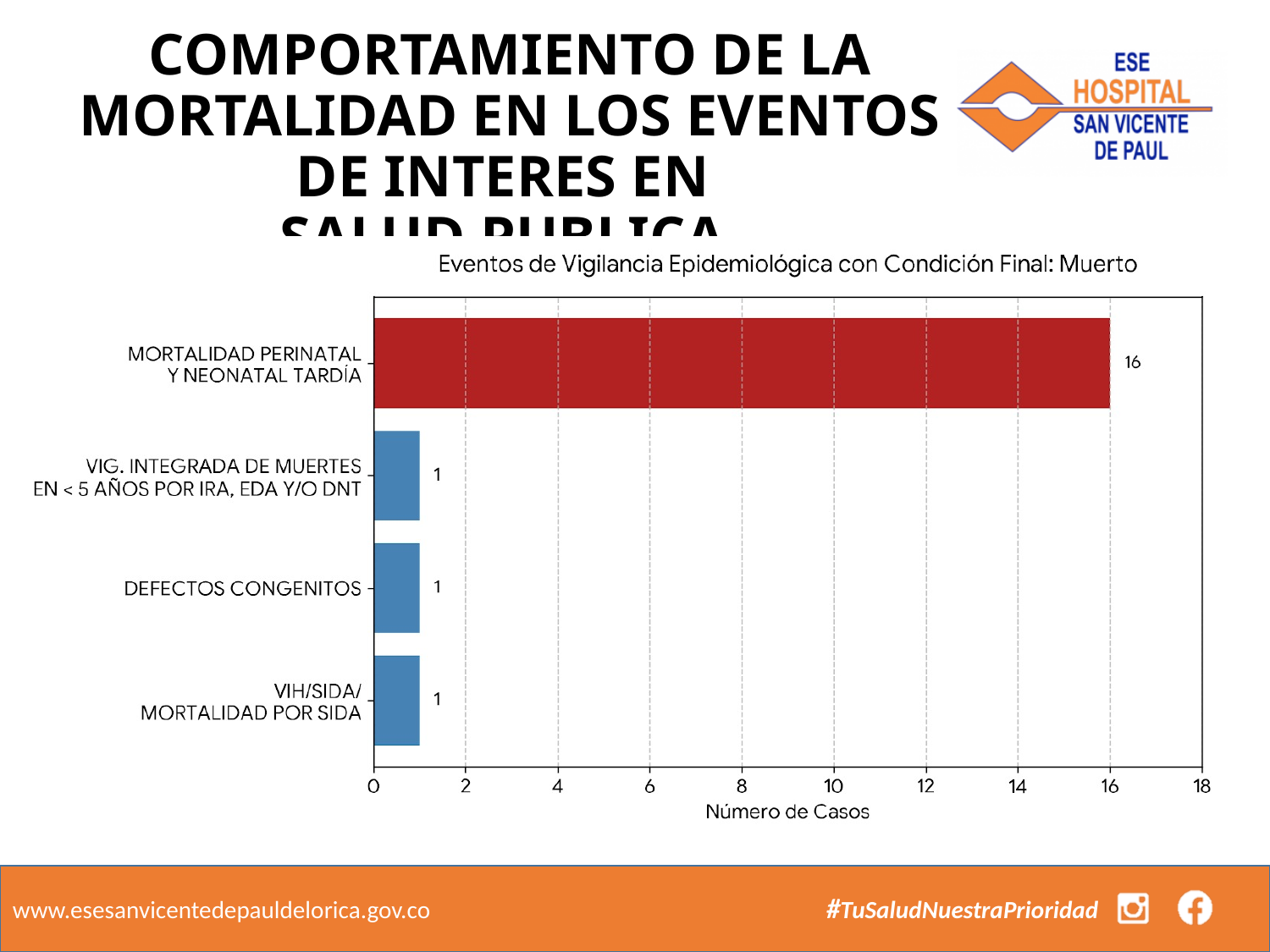
What is the number of cases for DEFECTOS CONGENITOS? 1 What is the number of cases for MORTALIDAD PERINATAL Y NEONATAL TARDÍA? 16 What kind of chart is shown on the slide? bar chart What is the title of the chart? Eventos de Vigilancia Epidemiológica con Condición Final: Muerto What is the difference in cases between MORTALIDAD PERINATAL Y NEONATAL TARDÍA and DEFECTOS CONGENITOS? 15 Is the value for MORTALIDAD PERINATAL Y NEONATAL TARDÍA greater or less than 10? greater What is the number of cases for VIH/SIDA/ MORTALIDAD POR SIDA? 1 What is the label of the horizontal axis? Número de Casos Which has more cases, MORTALIDAD PERINATAL Y NEONATAL TARDÍA or VIH/SIDA/ MORTALIDAD POR SIDA? MORTALIDAD PERINATAL Y NEONATAL TARDÍA Which event has the highest number of cases? MORTALIDAD PERINATAL Y NEONATAL TARDÍA How many events (categories) are shown in the chart? 4 What is the number of cases for VIG. INTEGRADA DE MUERTES EN < 5 AÑOS POR IRA, EDA Y/O DNT? 1